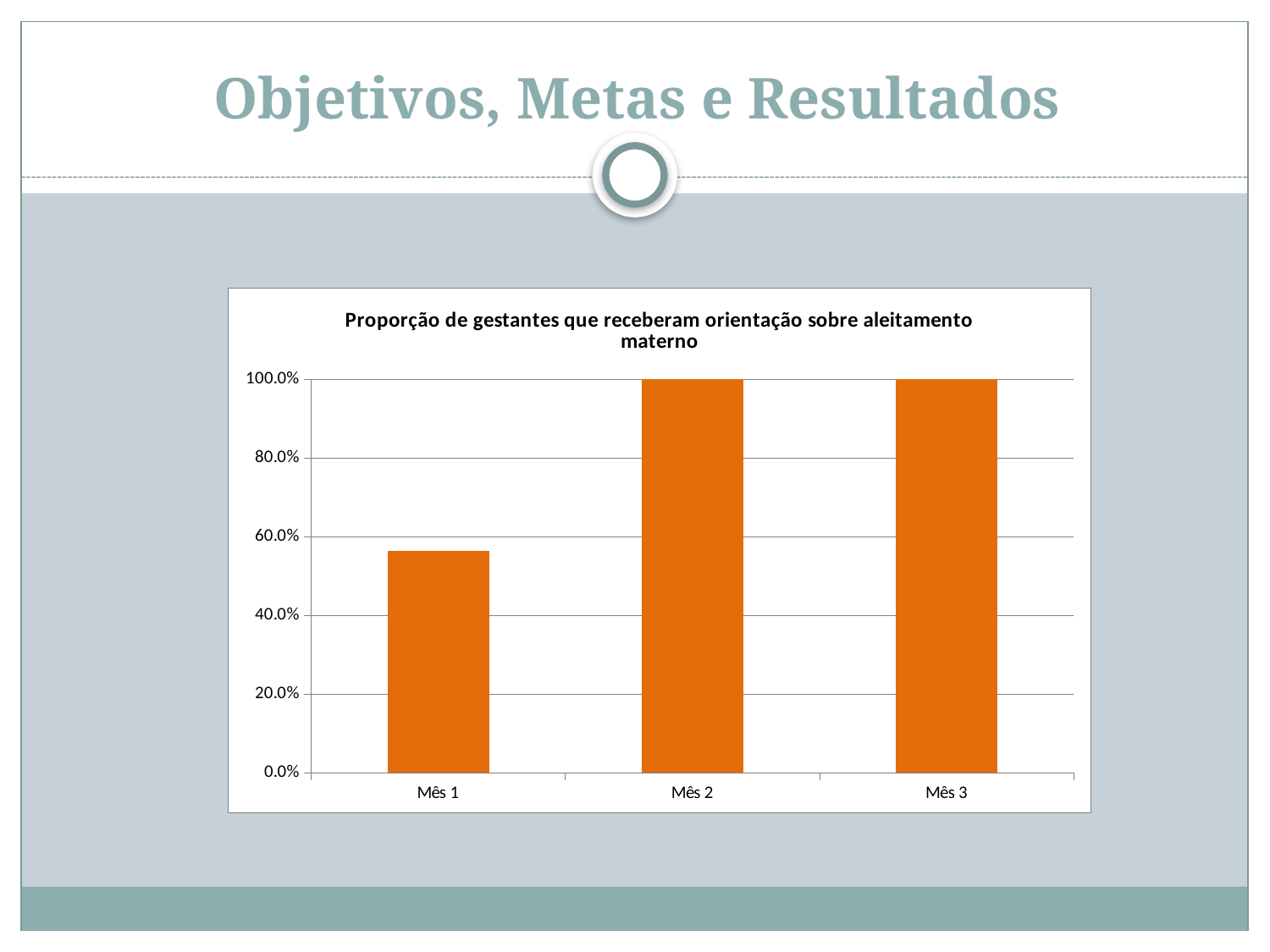
Is the value for Mês 1 greater or less than 60.0%? less Which month has the lowest value? Mês 1 What is the title of the chart? Proporção de gestantes que receberam orientação sobre aleitamento materno What kind of chart is shown on the slide? bar chart Does the value rise or fall from Mês 1 to Mês 2? rise What is the highest value shown on the y axis of the chart? 100.0% How many categories (months) are shown on the x axis of the chart? 3 What colour are the bars in the chart? orange What is the value for Mês 3? 100.0% Which is larger, the value for Mês 1 or the value for Mês 2? Mês 2 What is the value for Mês 2? 100.0% Is the value for Mês 1 greater or less than 40.0%? greater